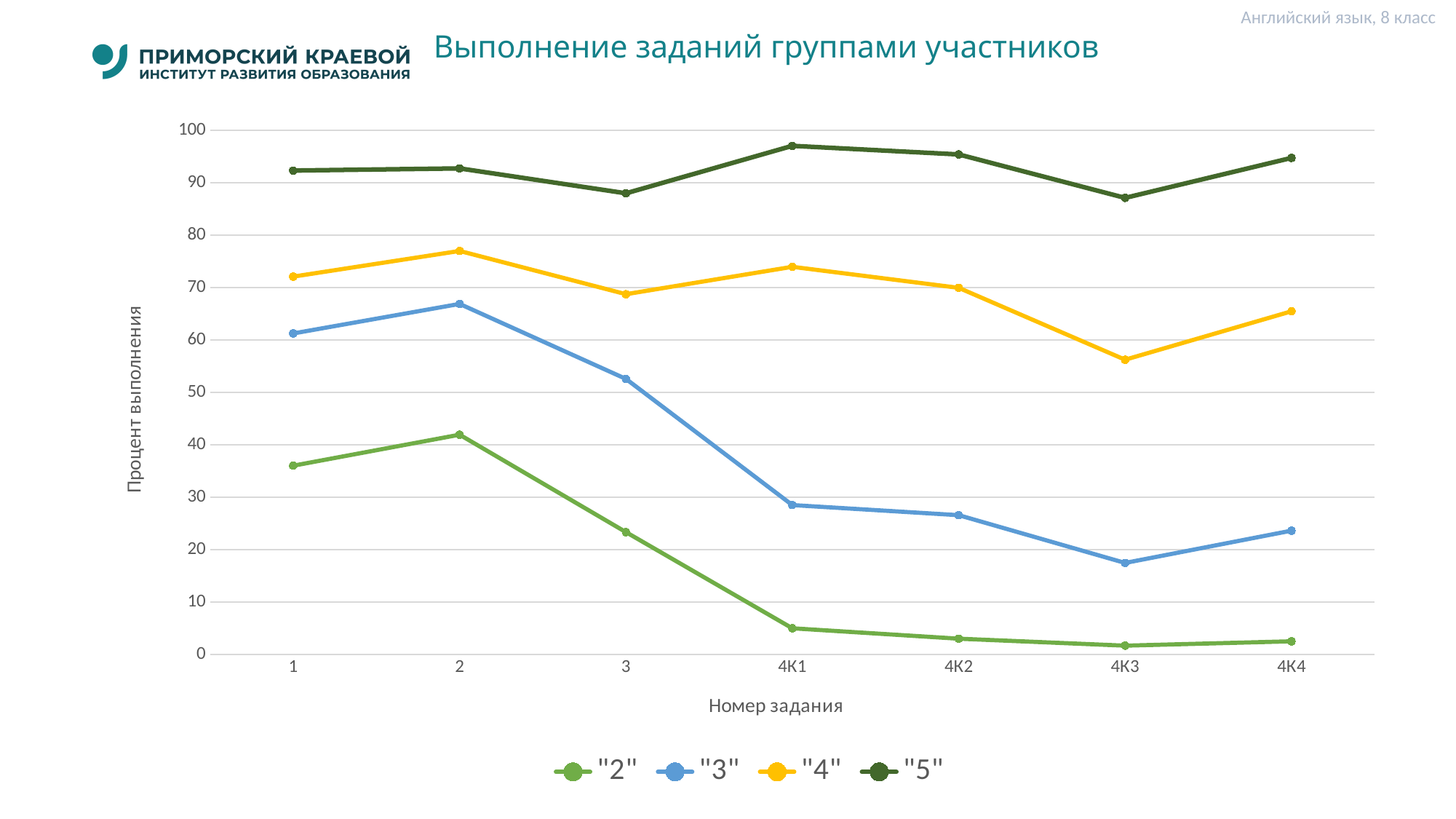
Is the value for series "4" at task 4К3 greater or less than 60? less For which task does the series "3" reach its lowest value? 4К3 Is the value for series "2" at task 2 greater or less than 40? greater For which task does the series "2" reach its highest value? 2 What is the title of the x axis? Номер задания How many task numbers are shown along the x axis? 7 How many series does the legend list? 4 Does the series "2" rise or fall from task 3 to task 4К1? fall For which task does the series "4" reach its lowest value? 4К3 Is the value for series "2" at task 4К1 greater or less than 10? less Which series has the larger value at task 3, "4" or "3"? "4" What kind of chart is shown on the slide? line chart